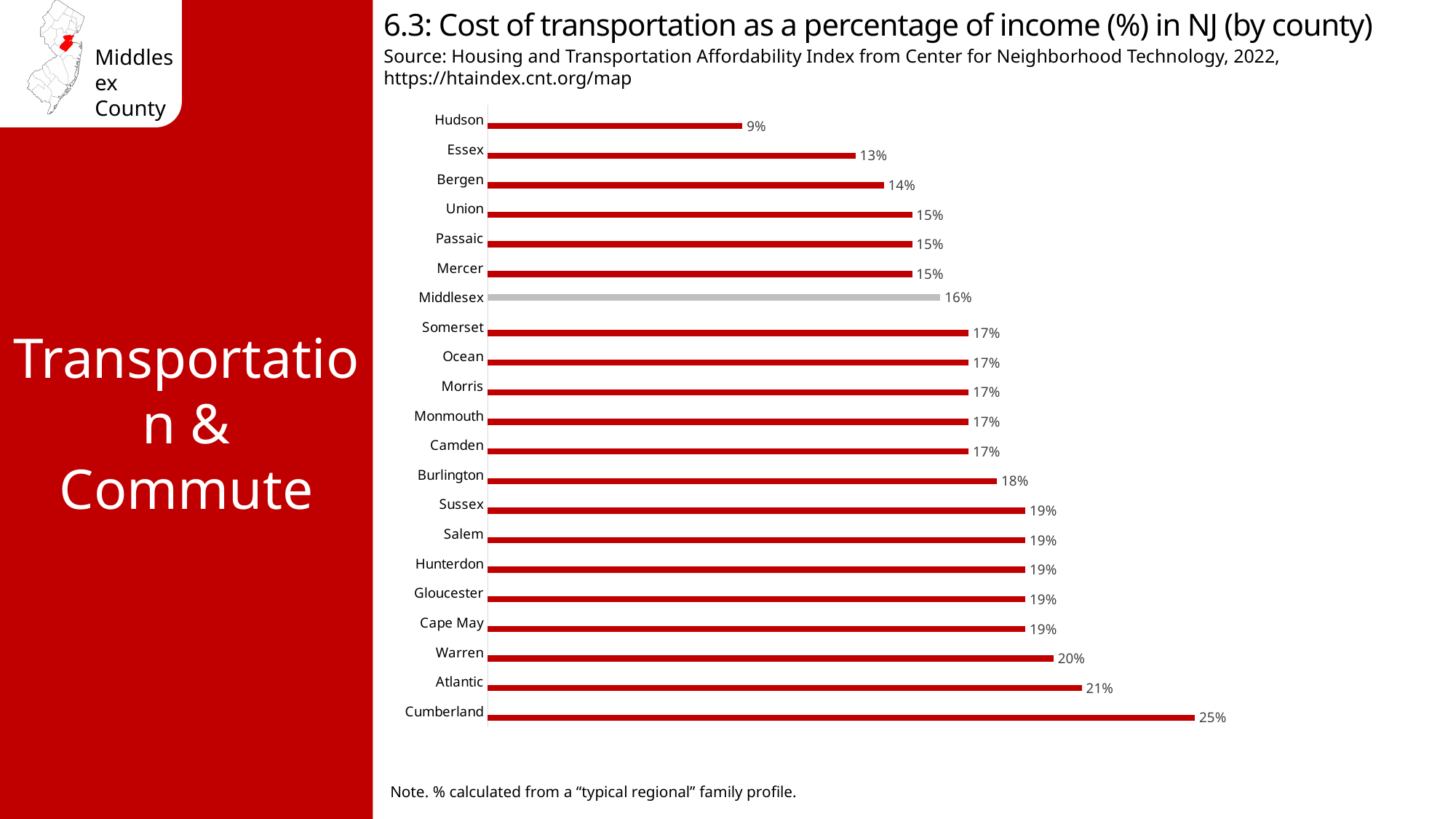
What is the cost of transportation as a percentage of income for Cumberland County? 25% What is the value shown for Burlington County? 18% Which county has the highest cost of transportation as a percentage of income? Cumberland Which county has the lowest cost of transportation as a percentage of income? Hudson Which has a higher value, Warren or Bergen? Warren What is the difference between the values for Atlantic and Middlesex? 5% What type of chart is shown on the slide? Bar chart What is the value shown for Hudson County? 9% What is the cost of transportation as a percentage of income for Middlesex County? 16% Which county's bar is shown in grey rather than red? Middlesex How many counties are shown in the chart? 21 What is the difference between the values for Cumberland and Hudson? 16%